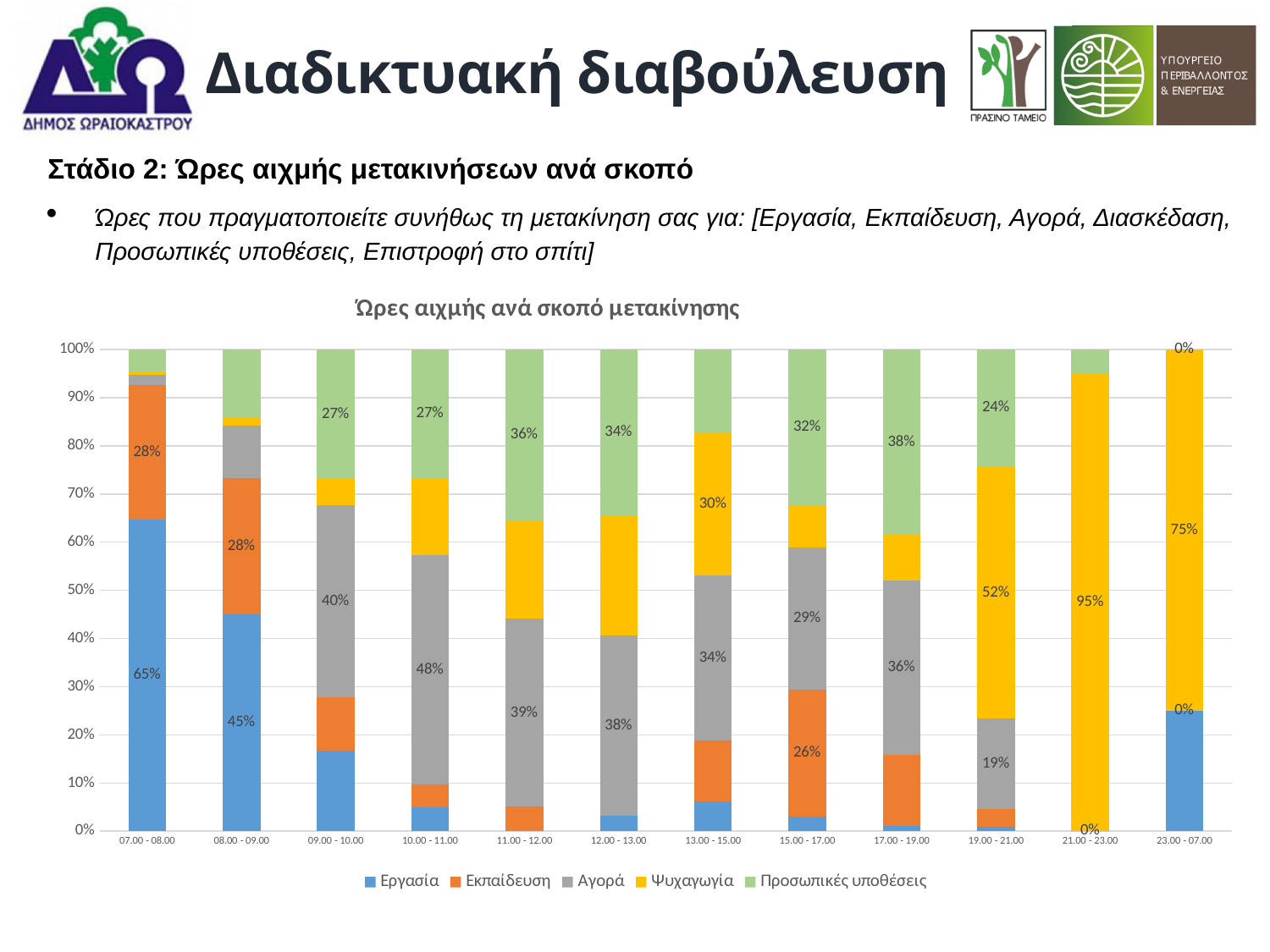
Is the Ψυχαγωγία value for 19.00 - 21.00 greater or less than 50%? greater What is the value for Αγορά in the 10.00 - 11.00 time slot? 48% How many series does the legend list? 5 How many time-slot categories are shown on the x axis? 12 What is the difference between the Εργασία values for 07.00 - 08.00 and 08.00 - 09.00? 20% What is the value for Ψυχαγωγία in the 21.00 - 23.00 time slot? 95% What is the title of the chart? Ώρες αιχμής ανά σκοπό μετακίνησης In the 15.00 - 17.00 time slot, which is larger: Αγορά or Προσωπικές υποθέσεις? Προσωπικές υποθέσεις What kind of chart is shown on the slide? Stacked bar chart What is the value for Εργασία in the 07.00 - 08.00 time slot? 65% What is the value for Προσωπικές υποθέσεις in the 17.00 - 19.00 time slot? 38% Which time slot has the highest labelled Ψυχαγωγία value? 21.00 - 23.00